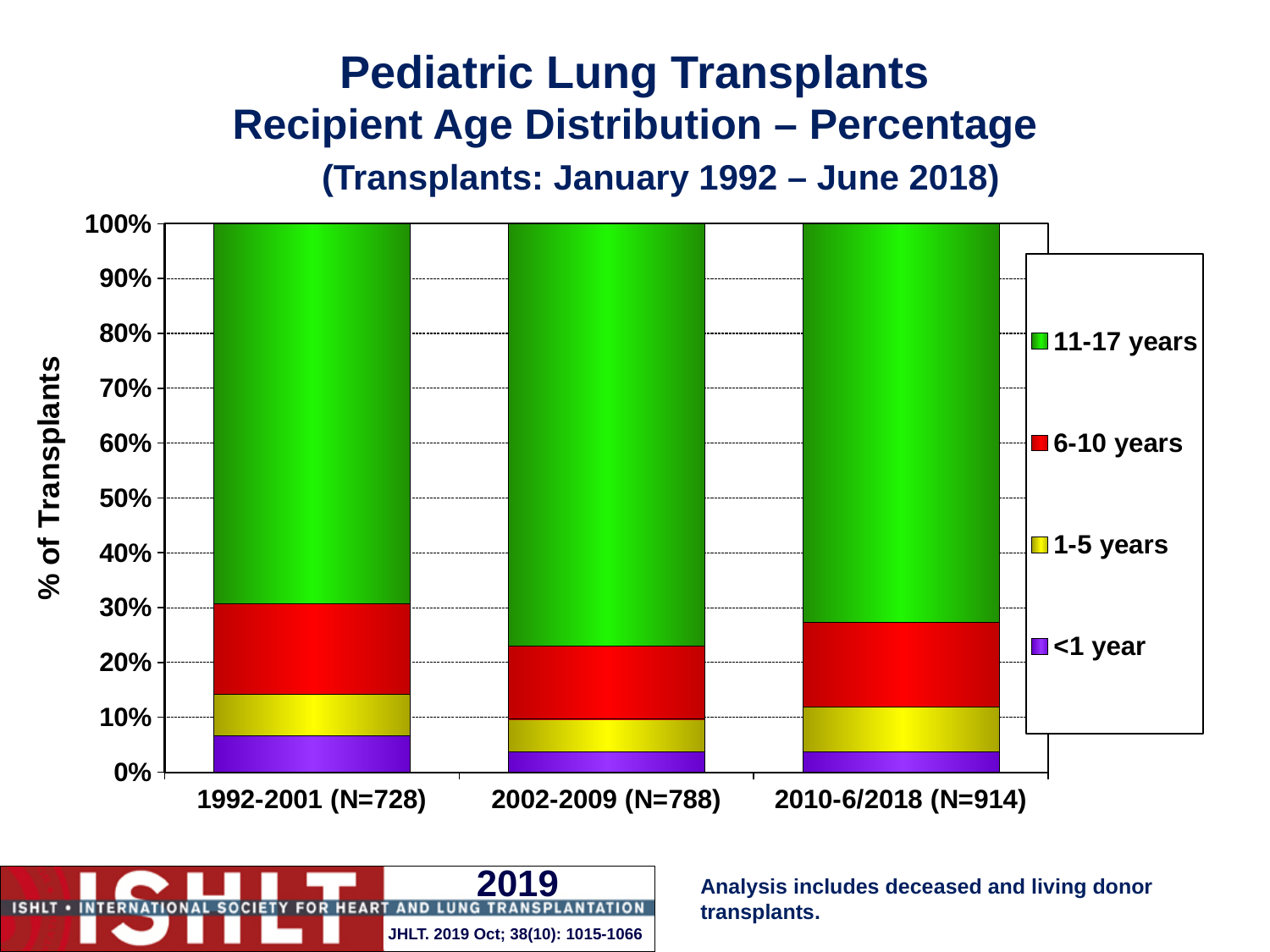
Is the share of recipients aged <1 year in 1992-2001 greater or less than 10%? less Which period has the largest share of recipients aged 11-17 years? 2002-2009 (N=788) Which age group makes up the largest share of transplants in every period? 11-17 years Which period has the largest share of recipients aged <1 year? 1992-2001 (N=728) How many time-period categories are shown on the x axis? 3 What kind of chart is shown on the slide? Stacked bar chart How many age groups does the legend list? 4 Is the share of recipients aged 6-10 years in 1992-2001 greater or less than 10%? greater What is the N shown for the 2010-6/2018 period? 914 Is the share of recipients aged <1 year larger in 1992-2001 or in 2002-2009? 1992-2001 Does the share of recipients aged <1 year rise or fall from the 1992-2001 period to the 2010-6/2018 period? fall Is the share of recipients aged 11-17 years in 2002-2009 greater or less than 70%? greater